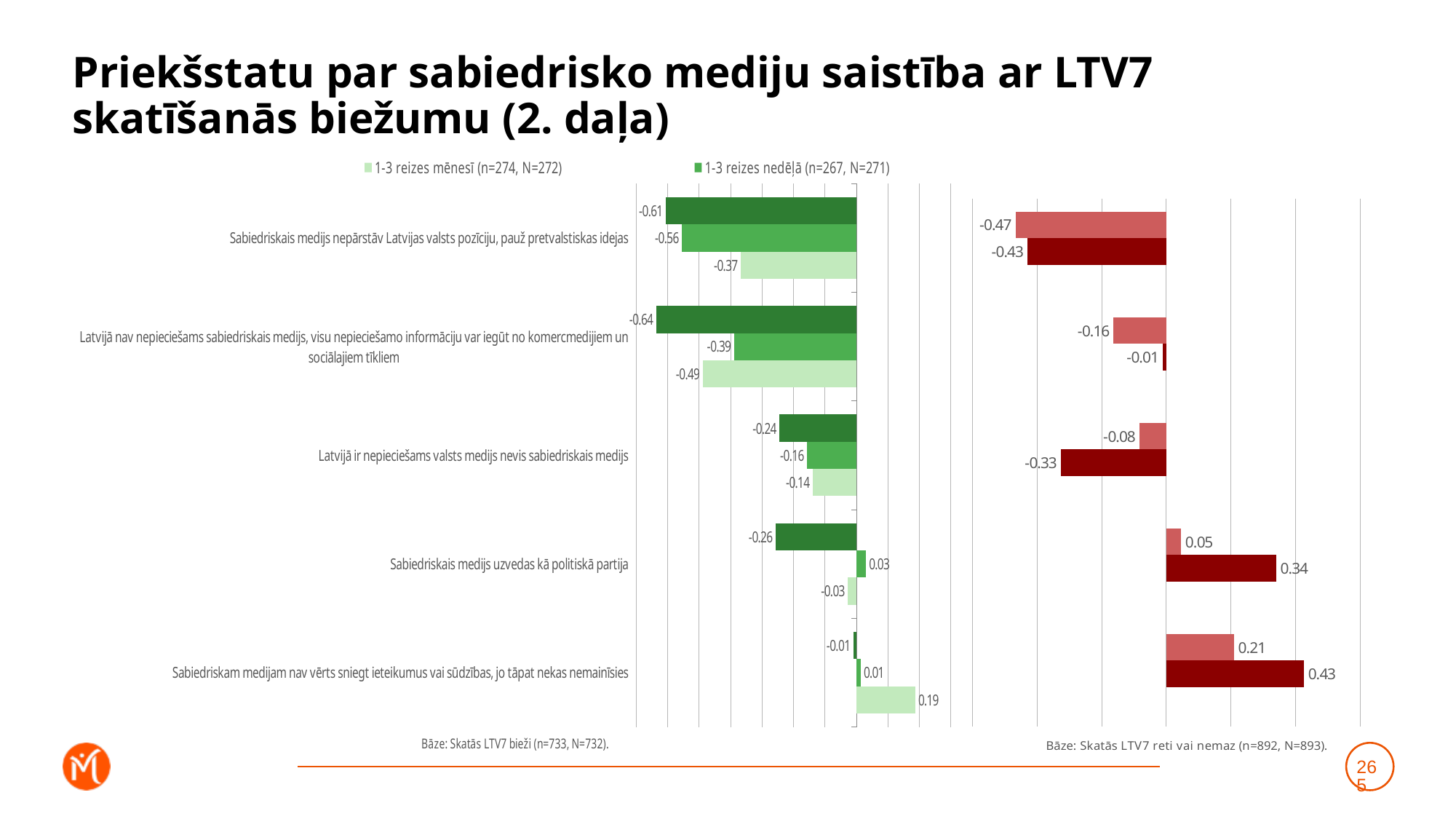
In the left chart, what is the value of the '1-3 reizes mēnesī' series for 'Sabiedriskam medijam nav vērts sniegt ieteikumus vai sūdzības, jo tāpat nekas nemainīsies'? 0.19 In the right chart, what is the value of the light red bar for 'Latvijā ir nepieciešams valsts medijs nevis sabiedriskais medijs'? -0.08 In the left chart, which category has the lowest value for the '1-3 reizes nedēļā' series? Sabiedriskais medijs nepārstāv Latvijas valsts pozīciju, pauž pretvalstiskas idejas In the left chart, what is the difference between the '1-3 reizes nedēļā' value (-0.56) and the '1-3 reizes mēnesī' value (-0.37) for 'Sabiedriskais medijs nepārstāv Latvijas valsts pozīciju, pauž pretvalstiskas idejas'? 0.19 What type of chart is the left chart? bar chart In the left chart, what is the value of the '1-3 reizes nedēļā' series for 'Latvijā nav nepieciešams sabiedriskais medijs, visu nepieciešamo informāciju var iegūt no komercmedijiem un sociālajiem tīkliem'? -0.39 How many categories are shown on the left chart? 5 In the right chart, which category has the highest dark red bar value? Sabiedriskam medijam nav vērts sniegt ieteikumus vai sūdzības, jo tāpat nekas nemainīsies How many series does the legend at the top of the slide list? 2 In the left chart, what is the value of the '1-3 reizes mēnesī' series for 'Sabiedriskais medijs nepārstāv Latvijas valsts pozīciju, pauž pretvalstiskas idejas'? -0.37 In the right chart, for 'Sabiedriskais medijs uzvedas kā politiskā partija', which bar is larger: the light red bar or the dark red bar? the dark red bar In the right chart, what is the value of the dark red bar for 'Sabiedriskam medijam nav vērts sniegt ieteikumus vai sūdzības, jo tāpat nekas nemainīsies'? 0.43